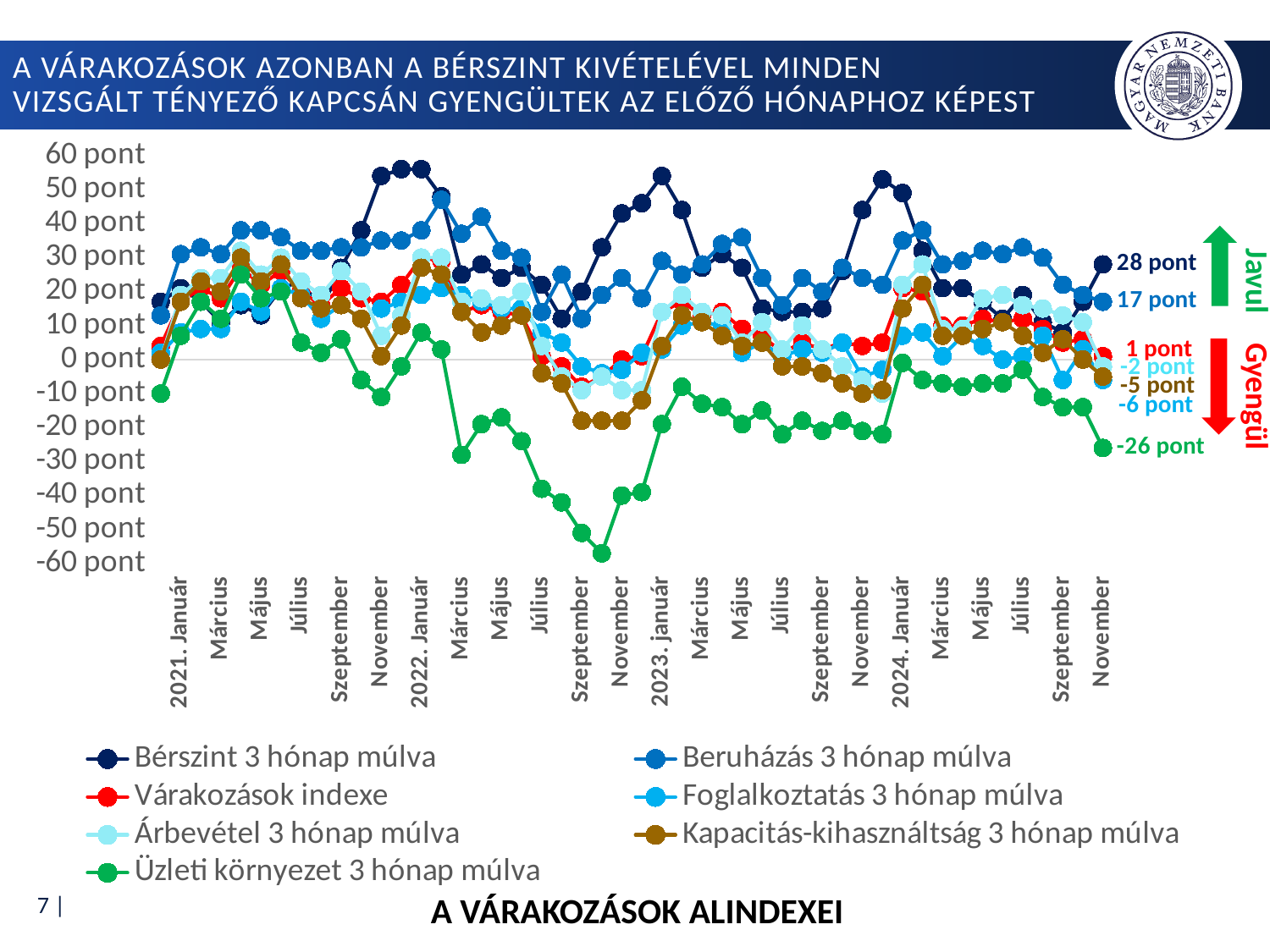
What is the difference between the final values of Bérszint 3 hónap múlva and Beruházás 3 hónap múlva? 11 pont At the last data point, which is larger: Kapacitás-kihasználtság 3 hónap múlva or Árbevétel 3 hónap múlva? Árbevétel 3 hónap múlva How many series does the legend list? 7 What is the final value of the Foglalkoztatás 3 hónap múlva series? -6 pont What type of chart is shown on the slide? line chart What is the final value of the Várakozások indexe series? 1 pont What is the title shown below the chart? A VÁRAKOZÁSOK ALINDEXEI What is the final value of the Üzleti környezet 3 hónap múlva series? -26 pont What is the final (November 2024) value of the Bérszint 3 hónap múlva series? 28 pont Which series has the highest value at the last data point (November 2024)? Bérszint 3 hónap múlva Which series has the lowest value at the last data point (November 2024)? Üzleti környezet 3 hónap múlva What is the final value of the Beruházás 3 hónap múlva series? 17 pont